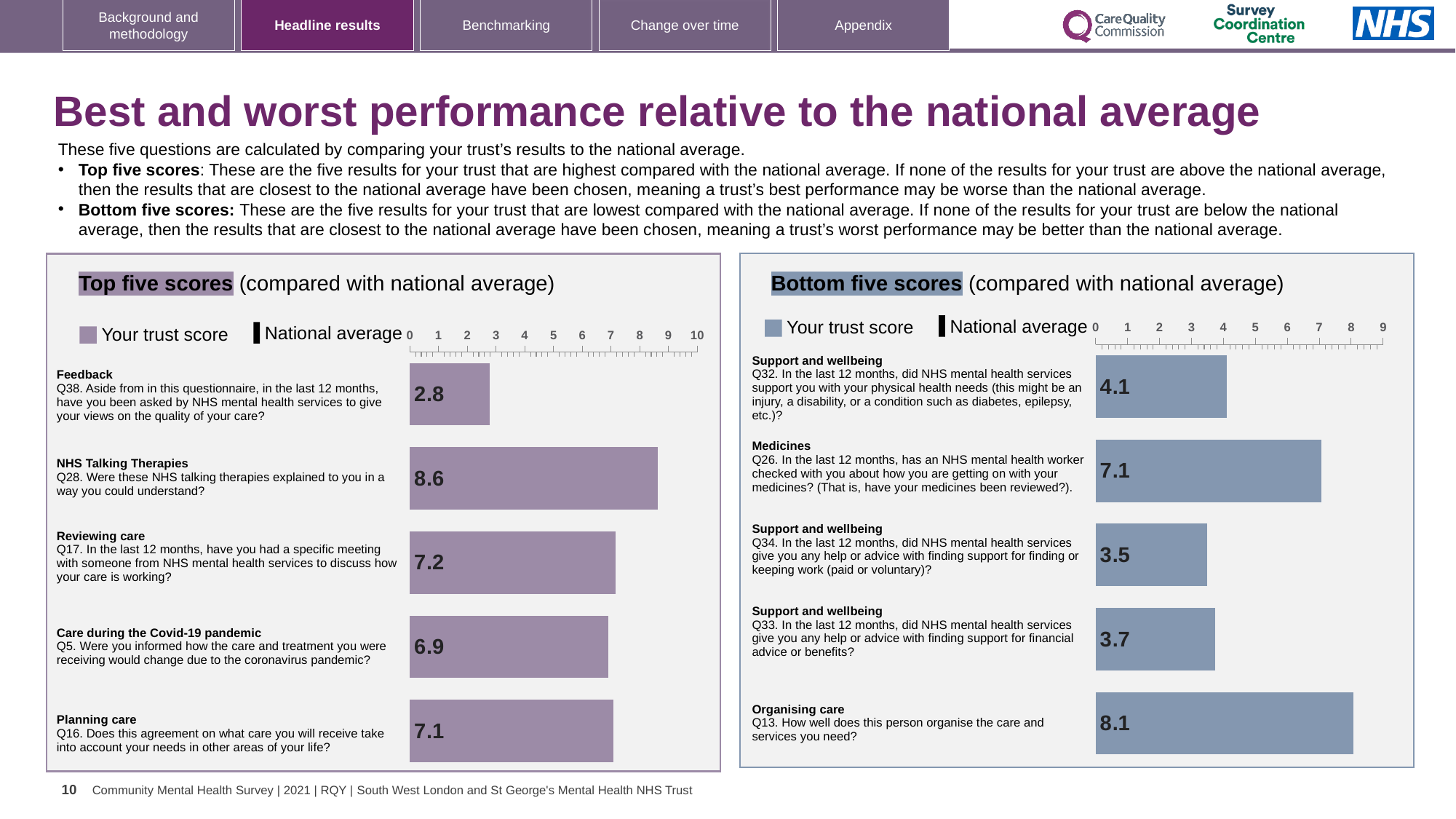
In the Bottom five scores chart, what is the trust score for Q26 (Medicines)? 7.1 In the Top five scores chart, which question has the highest trust score? Q28 (NHS Talking Therapies) In the Top five scores chart, what is the trust score for Q38 (Feedback)? 2.8 In the Bottom five scores chart, what is the trust score for Q13 (Organising care)? 8.1 In the Bottom five scores chart, which has the larger trust score, Q32 or Q33? Q32 How many questions are shown in the Bottom five scores chart? 5 What type of chart is the Top five scores chart? Bar chart In the Bottom five scores chart, what is the difference between the trust scores for Q13 and Q34? 4.6 In the Top five scores chart, is the trust score for Q5 greater or less than 5? greater In the Top five scores chart, what is the difference between the trust scores for Q28 and Q38? 5.8 In the Bottom five scores chart, which question has the lowest trust score? Q34 (Support and wellbeing) In the Top five scores chart, what is the trust score for Q28 (NHS Talking Therapies)? 8.6